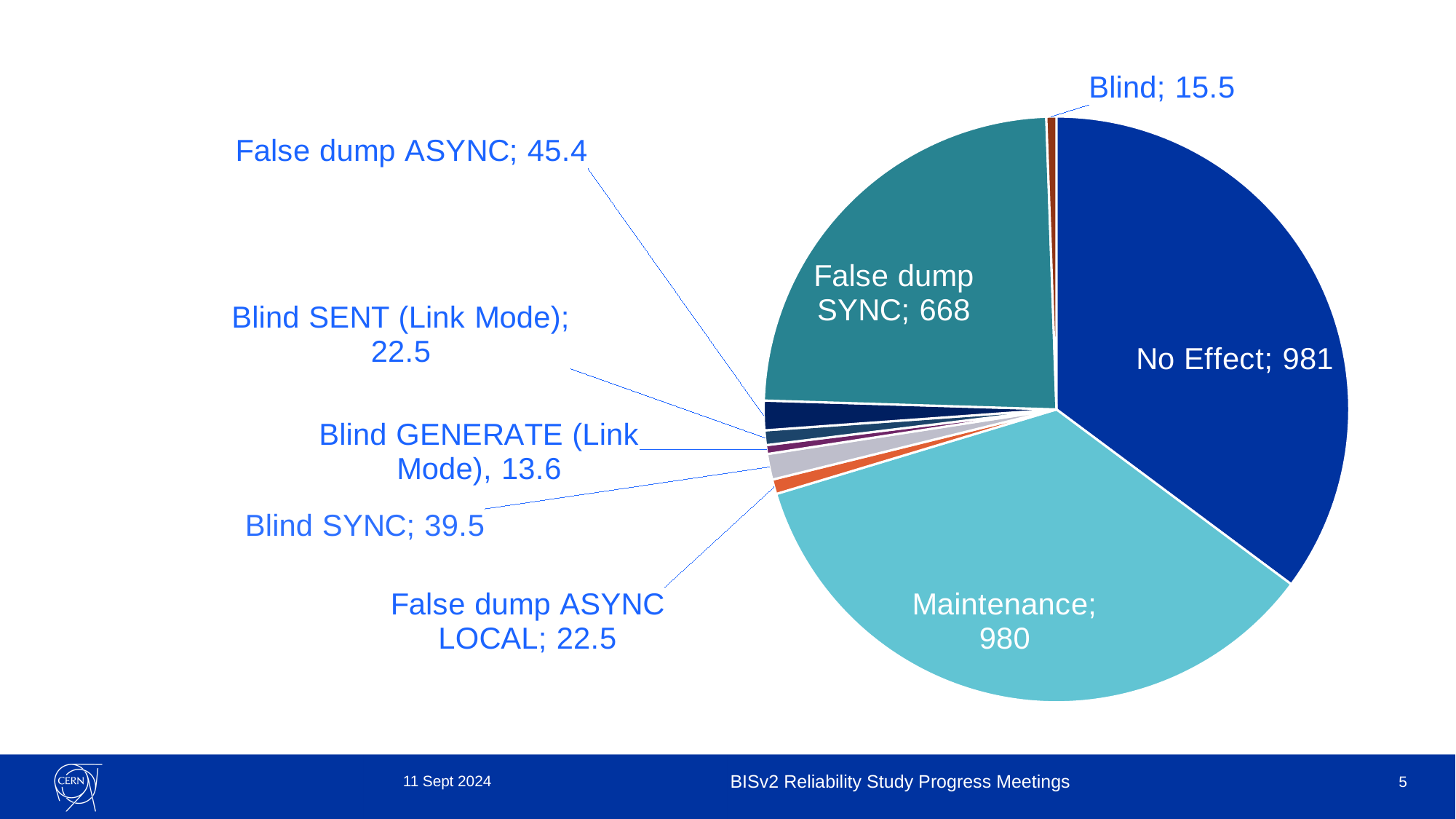
Which is larger, No Effect or False dump SYNC? No Effect What kind of chart is shown on the slide? pie chart What is the value for Blind SYNC? 39.5 What is the value for False dump ASYNC LOCAL? 22.5 What is the value for Blind GENERATE (Link Mode)? 13.6 Which is larger, Blind SYNC or Blind? Blind SYNC What is the value for No Effect? 981 What is the difference between the values for No Effect and False dump SYNC? 313 What is the value for False dump SYNC? 668 What is the difference between the values for False dump ASYNC and Blind SYNC? 5.9 What is the value for Maintenance? 980 How many slices does the pie chart have? 9